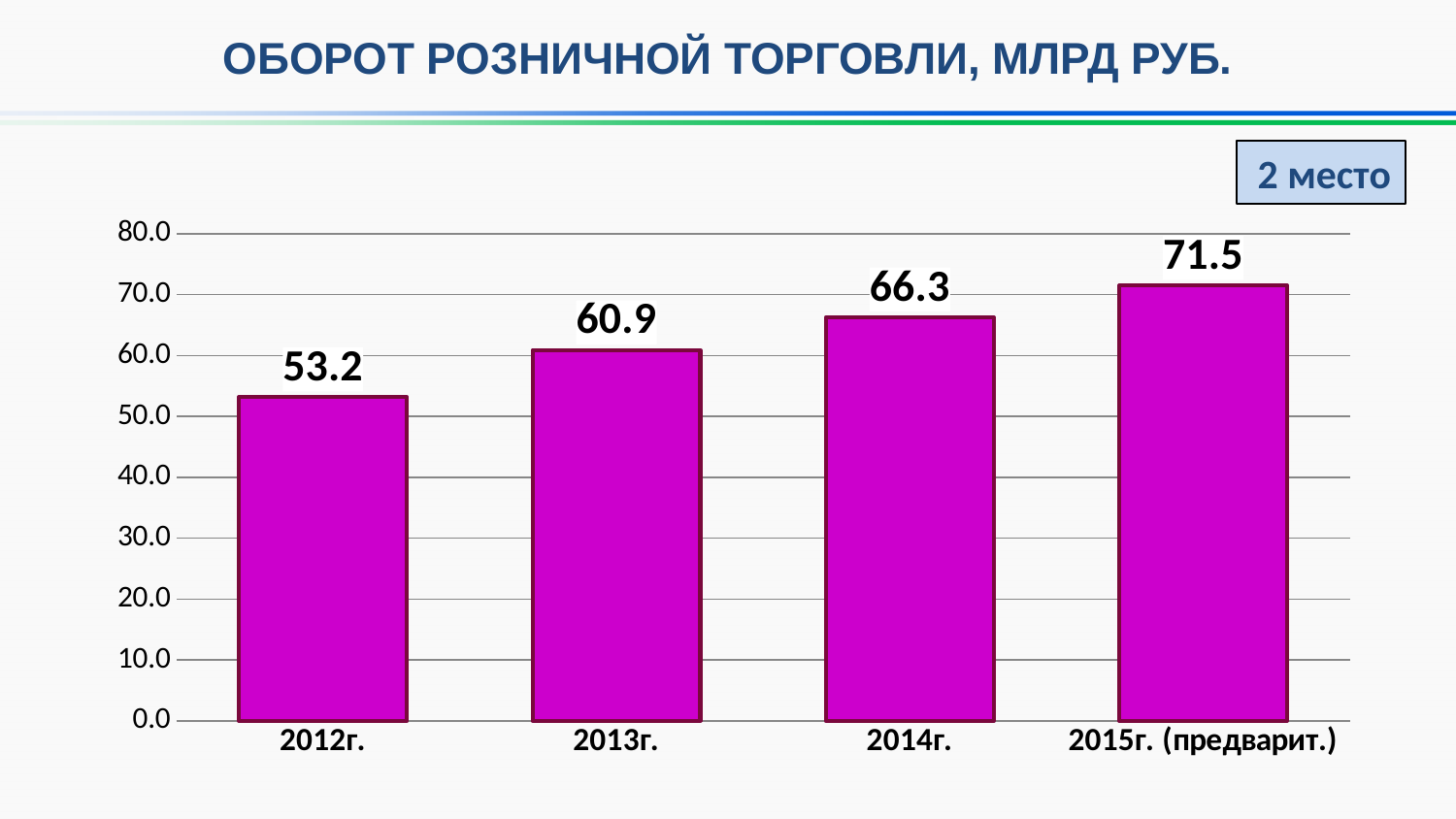
What is the value shown for 2013г.? 60.9 What kind of chart is shown on the slide? bar chart What is the retail trade turnover value for 2012г.? 53.2 What is the value shown for 2014г.? 66.3 Which year has the lowest value? 2012г. How many years are shown on the chart? 4 Which is larger, the value for 2013г. or the value for 2014г.? 2014г. What is the value shown for 2015г. (предварит.)? 71.5 What is the difference between the values for 2014г. and 2013г.? 5.4 Do the values rise or fall from 2012г. to 2015г. (предварит.)? rise Which year has the highest value? 2015г. (предварит.) What is the difference between the values for 2015г. (предварит.) and 2012г.? 18.3